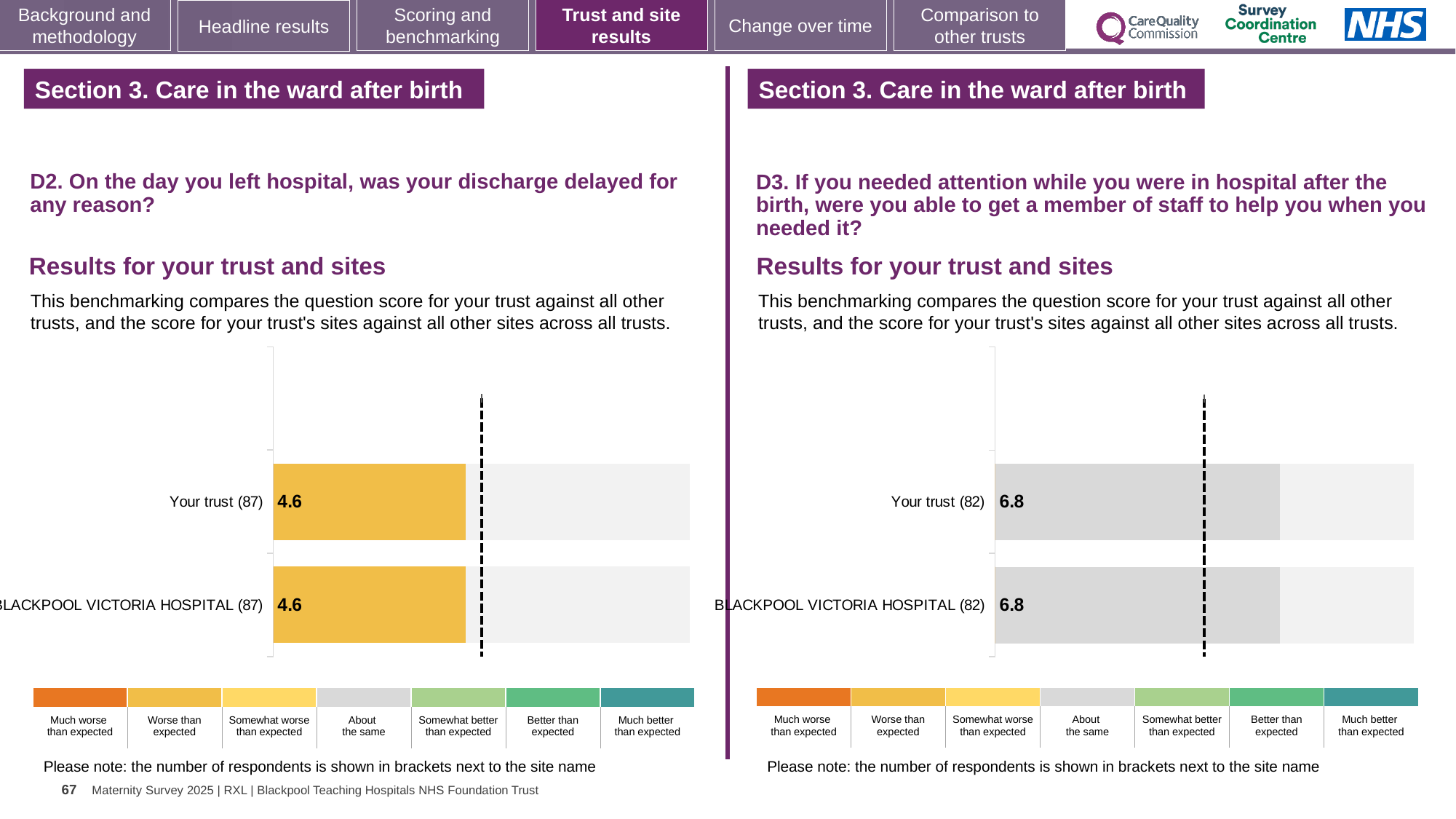
What kind of chart is used in the left chart (D2)? Bar chart In the right chart (D3), what is the difference between the score for Your trust and the score for BLACKPOOL VICTORIA HOSPITAL? 0 In the left chart (D2), what is the score for Your trust? 4.6 How many bars are plotted in the left chart (D2)? 2 In the left chart (D2), how many respondents are shown in brackets for Your trust? 87 In the left chart (D2), what is the score for BLACKPOOL VICTORIA HOSPITAL? 4.6 In the left chart (D2), what is the difference between the score for Your trust and the score for BLACKPOOL VICTORIA HOSPITAL? 0 In the right chart (D3), which benchmark category does the grey colour of the bars correspond to in the legend? About the same In the right chart (D3), what is the score for BLACKPOOL VICTORIA HOSPITAL? 6.8 In the right chart (D3), how many respondents are shown in brackets for BLACKPOOL VICTORIA HOSPITAL? 82 How many bars are plotted in the right chart (D3)? 2 In the right chart (D3), what is the score for Your trust? 6.8